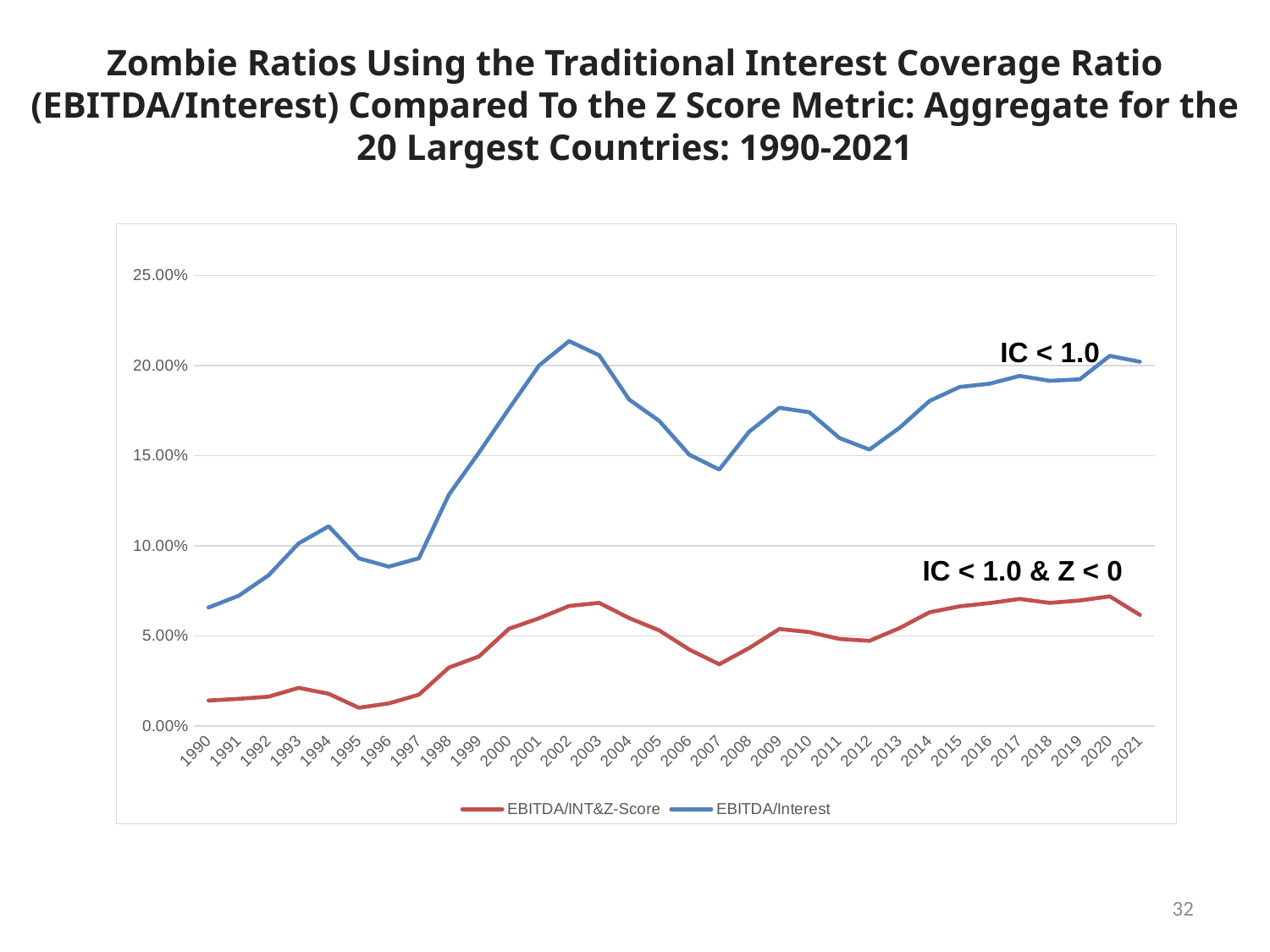
Does the EBITDA/Interest series rise or fall between 2002 and 2007? fall In which year is the EBITDA/INT&Z-Score series at its lowest value? 1995 How many years are plotted along the x axis? 32 What kind of chart is shown on the slide? line chart Is the value for EBITDA/INT&Z-Score in 2007 greater or less than 5.00%? less Is the value for EBITDA/Interest in 2002 greater or less than 20.00%? greater Is the value for EBITDA/Interest in 1996 greater or less than 10.00%? less In which year is the EBITDA/Interest series at its lowest value? 1990 Which series has the larger value in 2010, EBITDA/Interest or EBITDA/INT&Z-Score? EBITDA/Interest Which colour is used for the EBITDA/INT&Z-Score series? red How many series does the legend list? 2 In which year does the EBITDA/Interest series reach its highest value? 2002